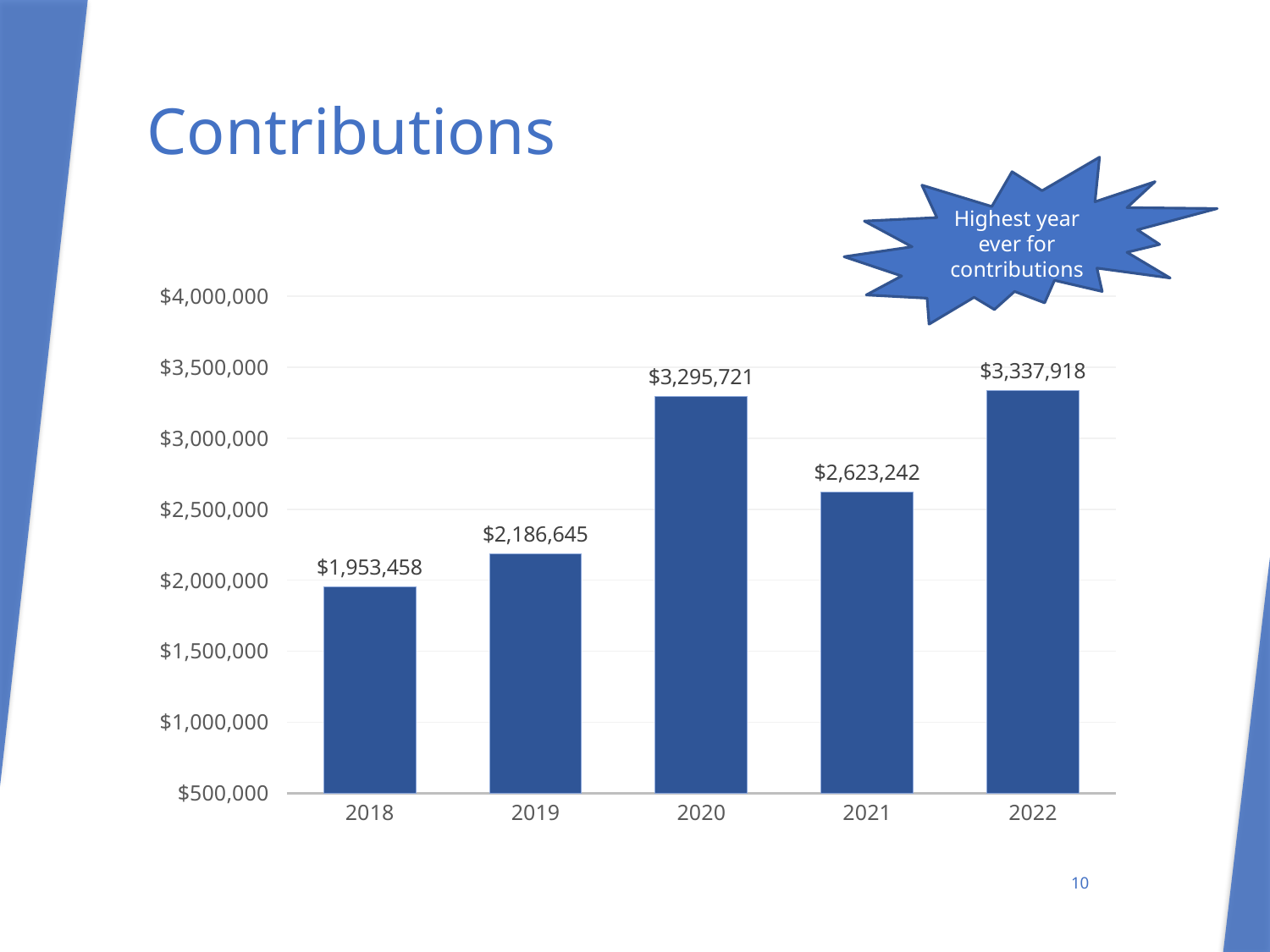
Did contributions rise or fall from 2020 to 2021? fall Which year had larger contributions, 2020 or 2021? 2020 What was the contribution value for 2022? $3,337,918 What is the difference between the 2019 and 2018 contribution values? $233,187 What is the difference between the 2022 and 2021 contribution values? $714,676 Which year had the lowest contributions? 2018 How many years are shown on the chart? 5 What kind of chart is shown on the slide? bar chart What was the contribution value for 2018? $1,953,458 Is the value for 2019 greater or less than $2,500,000? less Which year had the highest contributions? 2022 What was the contribution value for 2021? $2,623,242